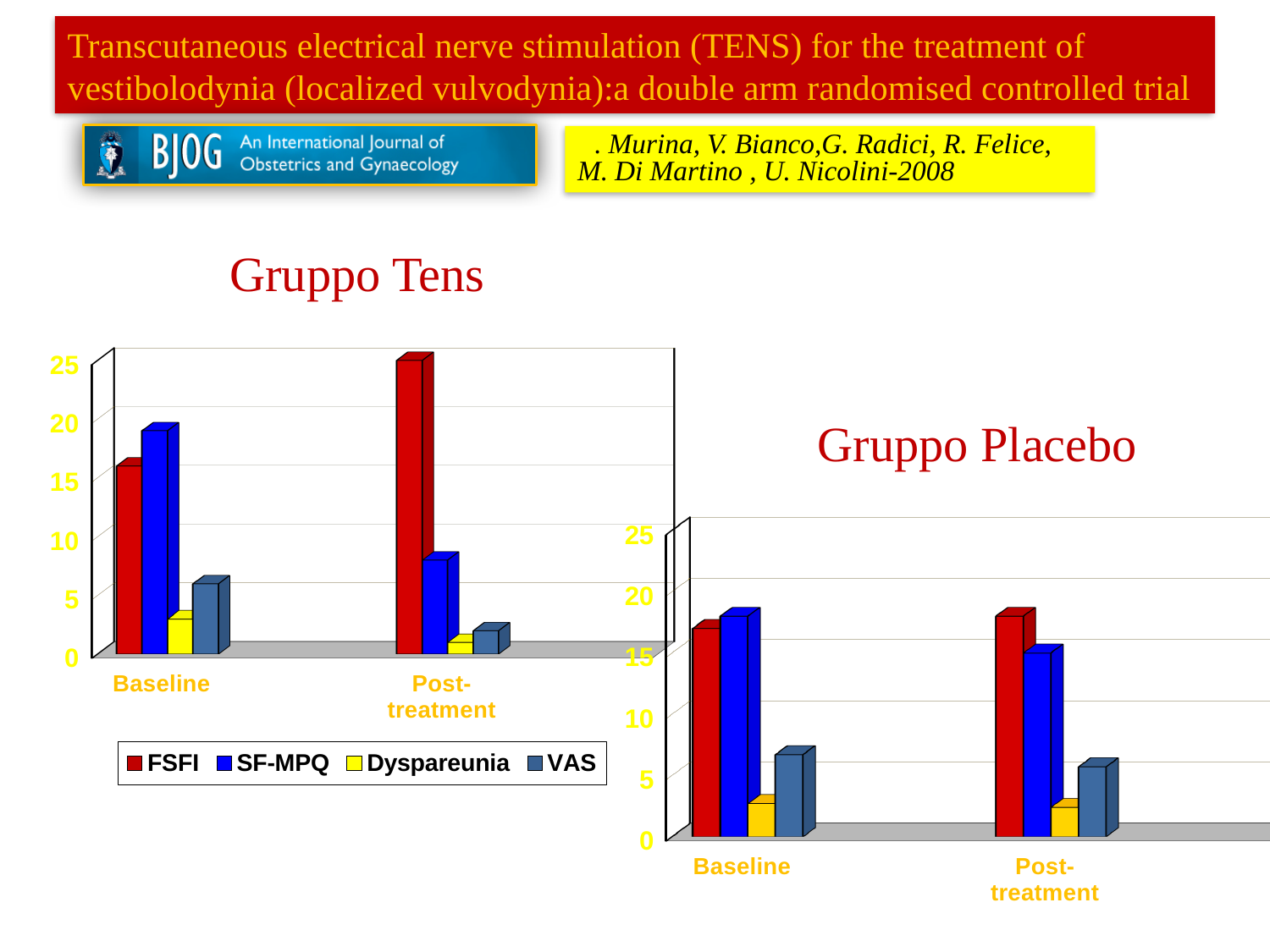
In the Gruppo Tens chart, is the FSFI value at Post-treatment greater or less than 20? greater In the Gruppo Tens chart, is the SF-MPQ value larger at Baseline or at Post-treatment? Baseline In the Gruppo Tens chart, is the SF-MPQ value at Post-treatment greater or less than 10? less In the Gruppo Placebo chart, is the SF-MPQ value at Post-treatment greater or less than 20? less Which series is shown in yellow in the legend of the Gruppo Tens chart? Dyspareunia In the Gruppo Tens chart, does the SF-MPQ value rise or fall from Baseline to Post-treatment? Fall In the Gruppo Tens chart, which series has the highest value at Post-treatment? FSFI How many categories are shown on the x axis of the Gruppo Placebo chart? 2 In the Gruppo Tens chart, which series has the lowest value at Post-treatment? Dyspareunia What kind of chart is the Gruppo Tens chart? Bar chart In the Gruppo Tens chart, which series has the highest value at Baseline? SF-MPQ How many series does the legend on the Gruppo Tens chart list? 4